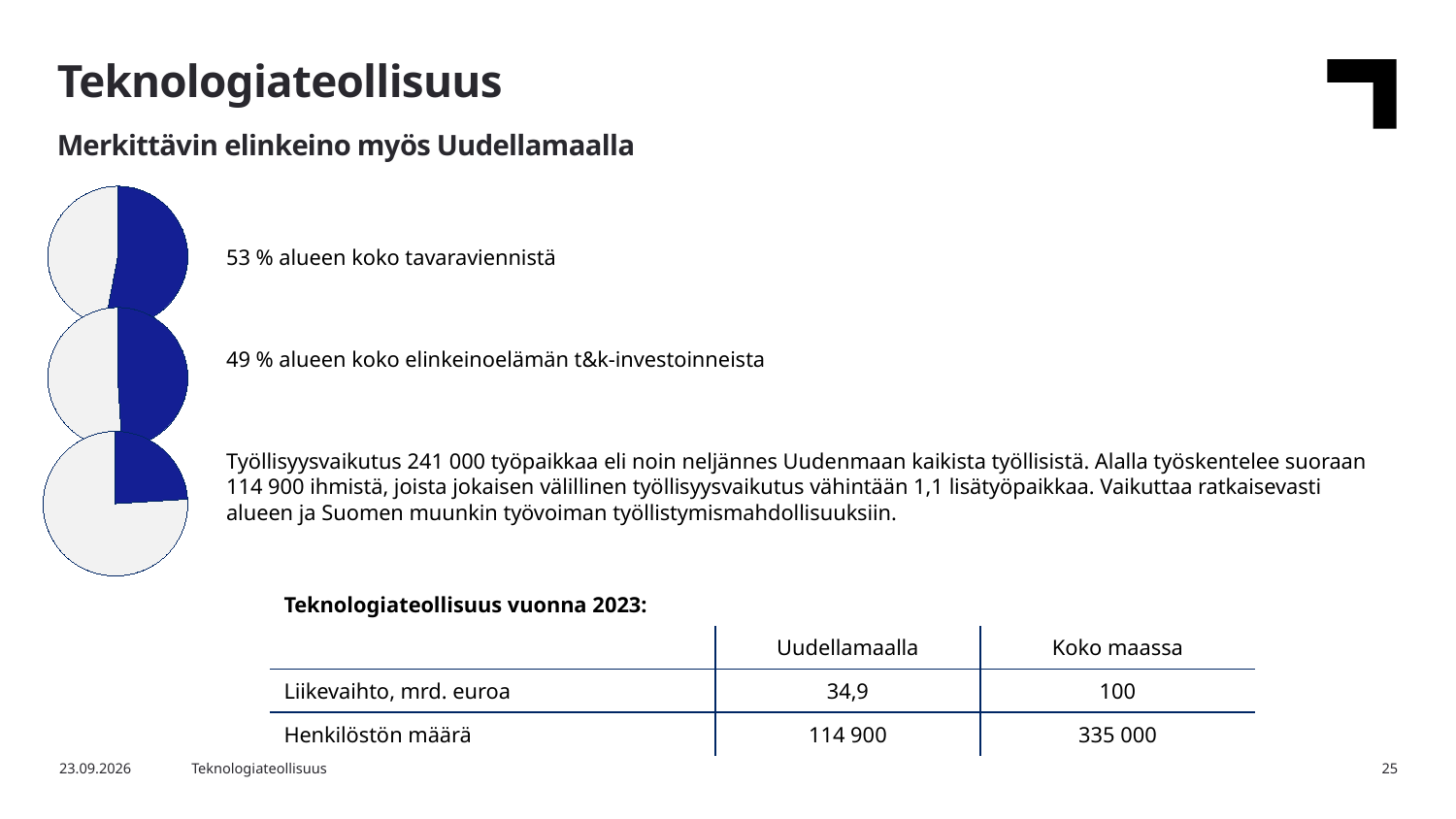
How many pie charts are on the slide? 3 How many slices does each pie chart have? 2 Is the blue share in the top pie chart greater or less than 50 %? greater In the top pie chart, what share of the region's total goods exports (tavaravienti) does the blue slice represent? 53 % In the middle pie chart, what share of the region's business R&D investments (t&k-investoinnit) does the blue slice represent? 49 % Which pie chart has the smallest blue slice: the top, middle or bottom one? bottom What is the difference in percentage points between the blue share of the top pie chart (53 %) and the middle pie chart (49 %)? 4 percentage points Is the blue share in the bottom pie chart greater or less than 50 %? less What kind of chart is shown on the left side of the slide? pie chart Which pie chart has the largest blue slice: the top, middle or bottom one? top What colour is used for the highlighted slice in each pie chart? blue Is the blue slice in the bottom pie chart larger or smaller than the blue slice in the top pie chart? smaller